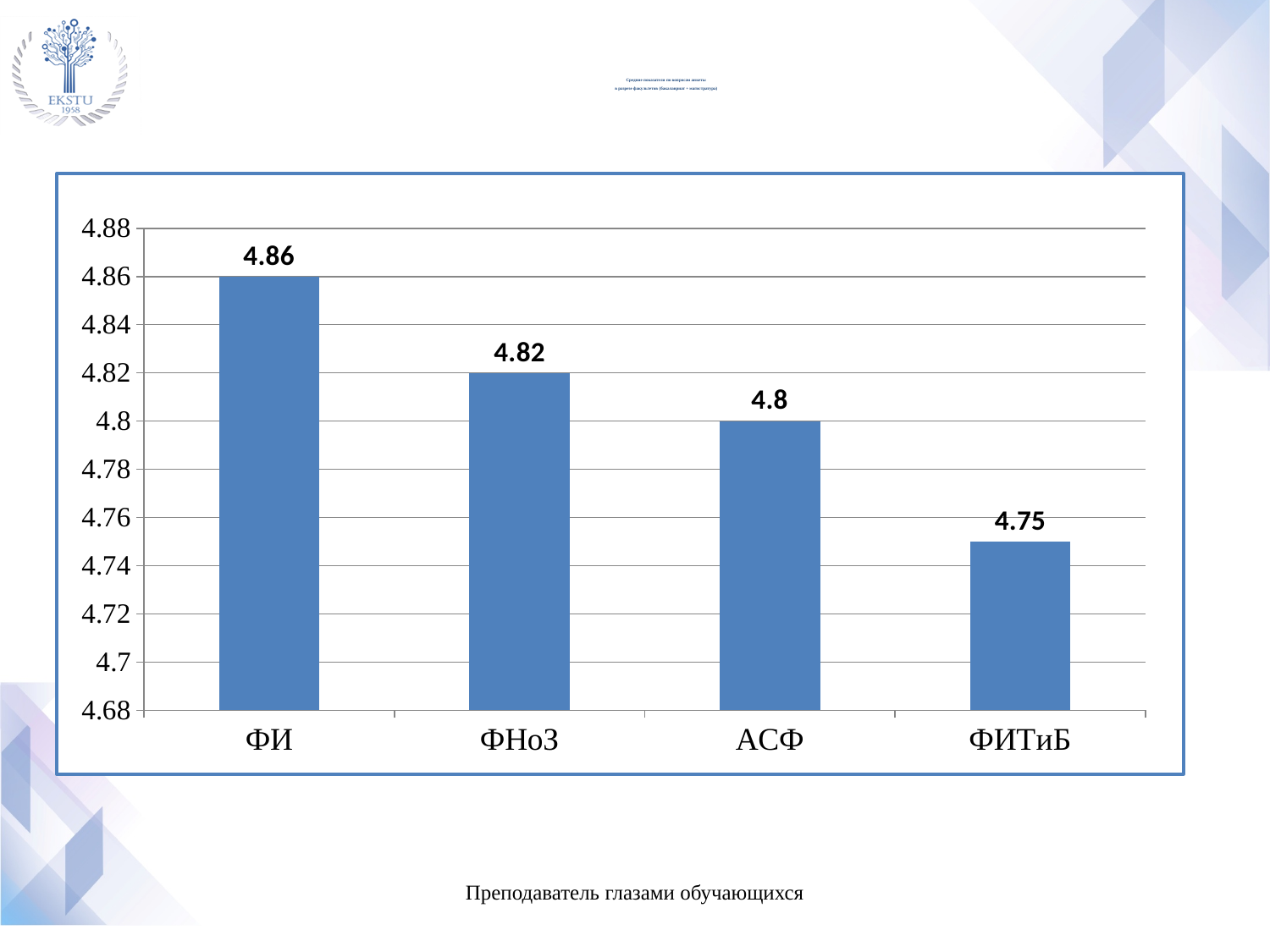
Which category has the highest value? ФИ What is the value for АСФ? 4.8 How many categories are shown on the x axis? 4 Do the values rise or fall from left to right along the x axis? Fall What is the value for ФНоЗ? 4.82 What is the value for ФИ? 4.86 Which is larger, the value for ФНоЗ or the value for ФИТиБ? ФНоЗ What is the value for ФИТиБ? 4.75 Which category has the lowest value? ФИТиБ What is the difference between the values for ФИ and ФИТиБ? 0.11 What kind of chart is shown on the slide? Bar chart What is the difference between the values for ФНоЗ and АСФ? 0.02